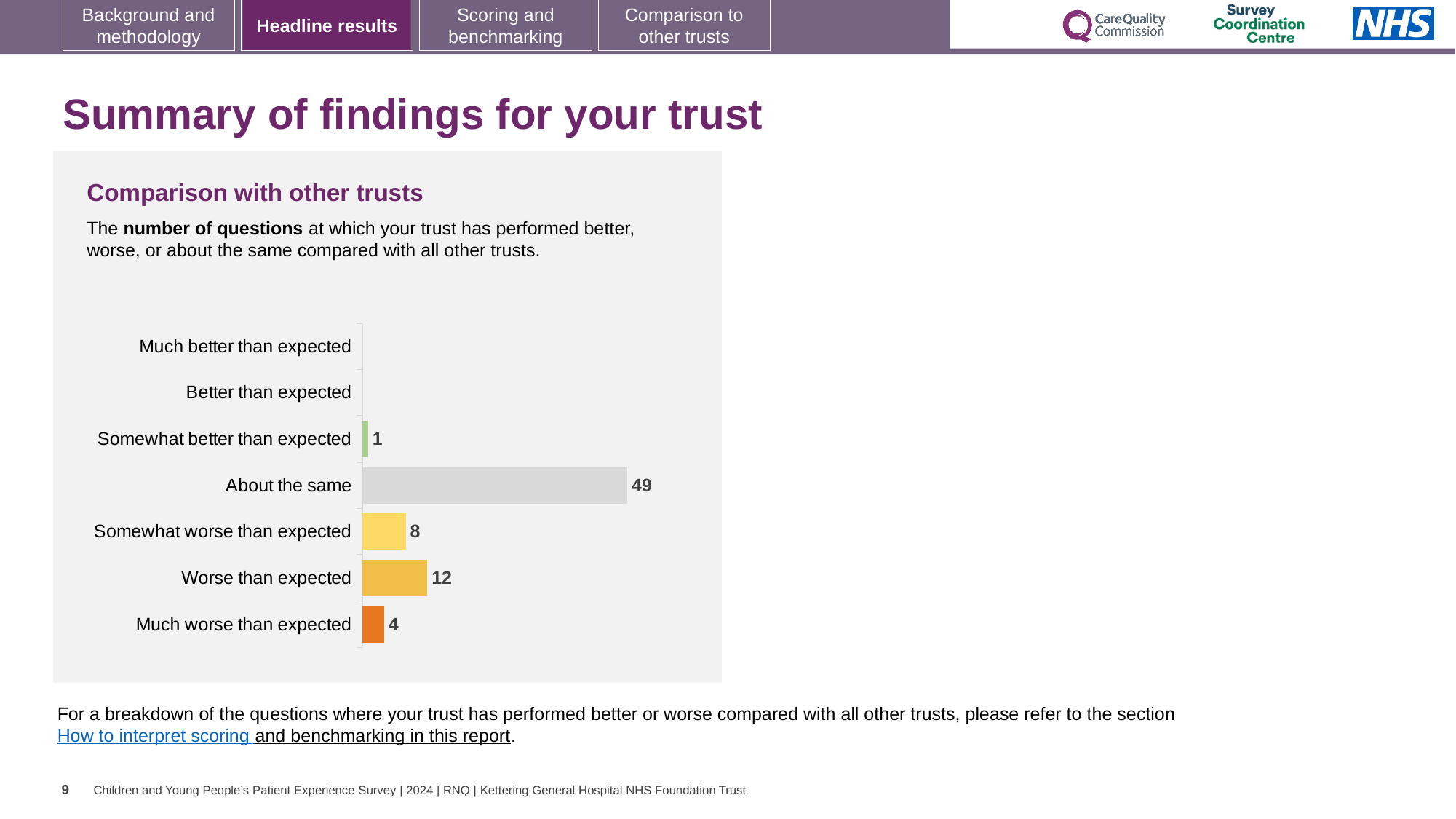
How many questions are in the 'About the same' category? 49 What kind of chart is shown on the slide? Bar chart Which category has the highest number of questions? About the same Which is larger: the value for 'Much worse than expected' or 'Somewhat worse than expected'? Somewhat worse than expected What is the value for 'Somewhat better than expected'? 1 What is the title of the chart section? Comparison with other trusts Among the categories with a labelled bar, which has the lowest value? Somewhat better than expected What is the value for 'Much worse than expected'? 4 What is the difference between the values for 'Worse than expected' and 'Somewhat worse than expected'? 4 What is the value for 'Somewhat worse than expected'? 8 How many categories are listed on the chart's axis? 7 What is the value for 'Worse than expected'? 12